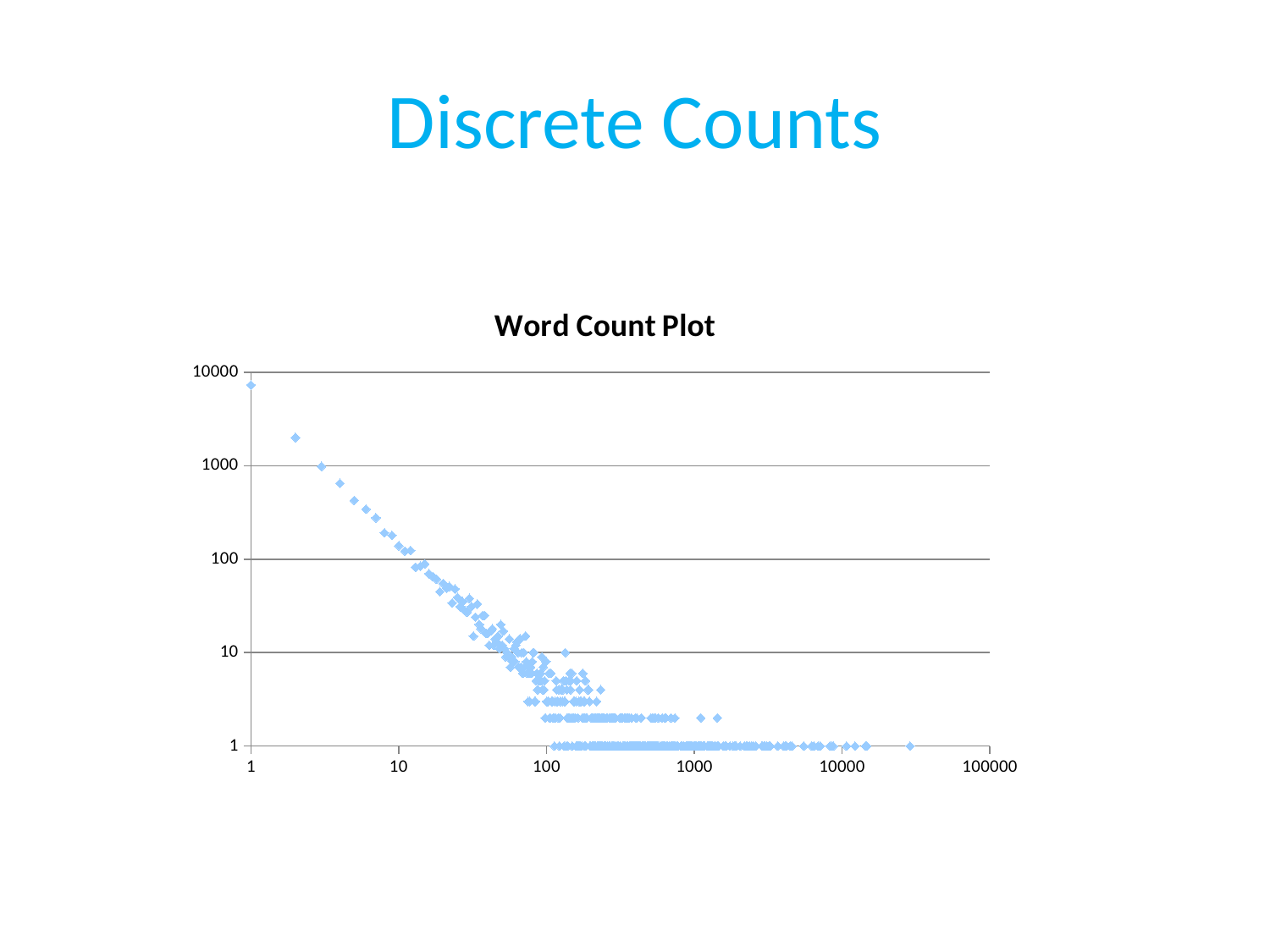
What is the lowest y-axis value that the plotted points reach? 1 Is the value plotted at x = 1 greater or less than 1000? greater Which is larger: the value plotted at x = 1 or the value plotted at x = 1000? x = 1 What is the largest tick label shown on the x axis? 100000 At which x-axis value does the highest plotted point occur? 1 Is the value plotted at x = 10 greater or less than 100? greater Is the value plotted at x = 10000 greater or less than 10? less What type of chart is shown on the slide? Scatter chart Do the plotted values rise or fall as the x-axis value increases? Fall What is the title of the chart? Word Count Plot